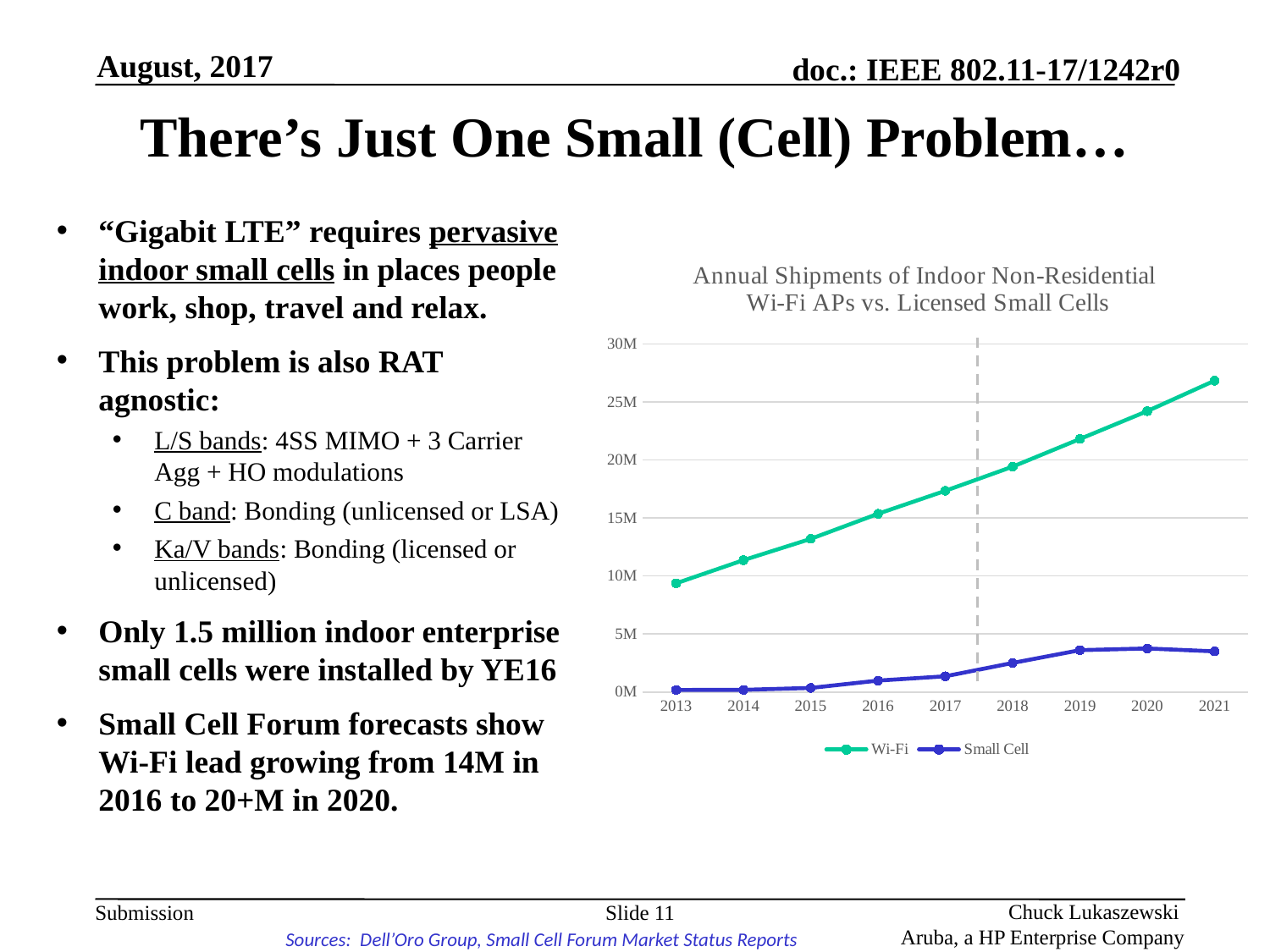
How many series does the chart legend list? 2 Is the Wi-Fi value for 2014 greater or less than 10M? greater Is the Wi-Fi value for 2013 greater or less than 10M? less In 2016, which series has the larger value, Wi-Fi or Small Cell? Wi-Fi Is the Wi-Fi value for 2021 greater or less than 25M? greater Do the Wi-Fi values rise or fall from 2013 to 2021? rise How many years are plotted along the x axis of the chart? 9 What is the title of the chart? Annual Shipments of Indoor Non-Residential Wi-Fi APs vs. Licensed Small Cells What kind of chart is shown on the slide? line chart In which year is the Wi-Fi series at its highest? 2021 In which year is the Wi-Fi series at its lowest? 2013